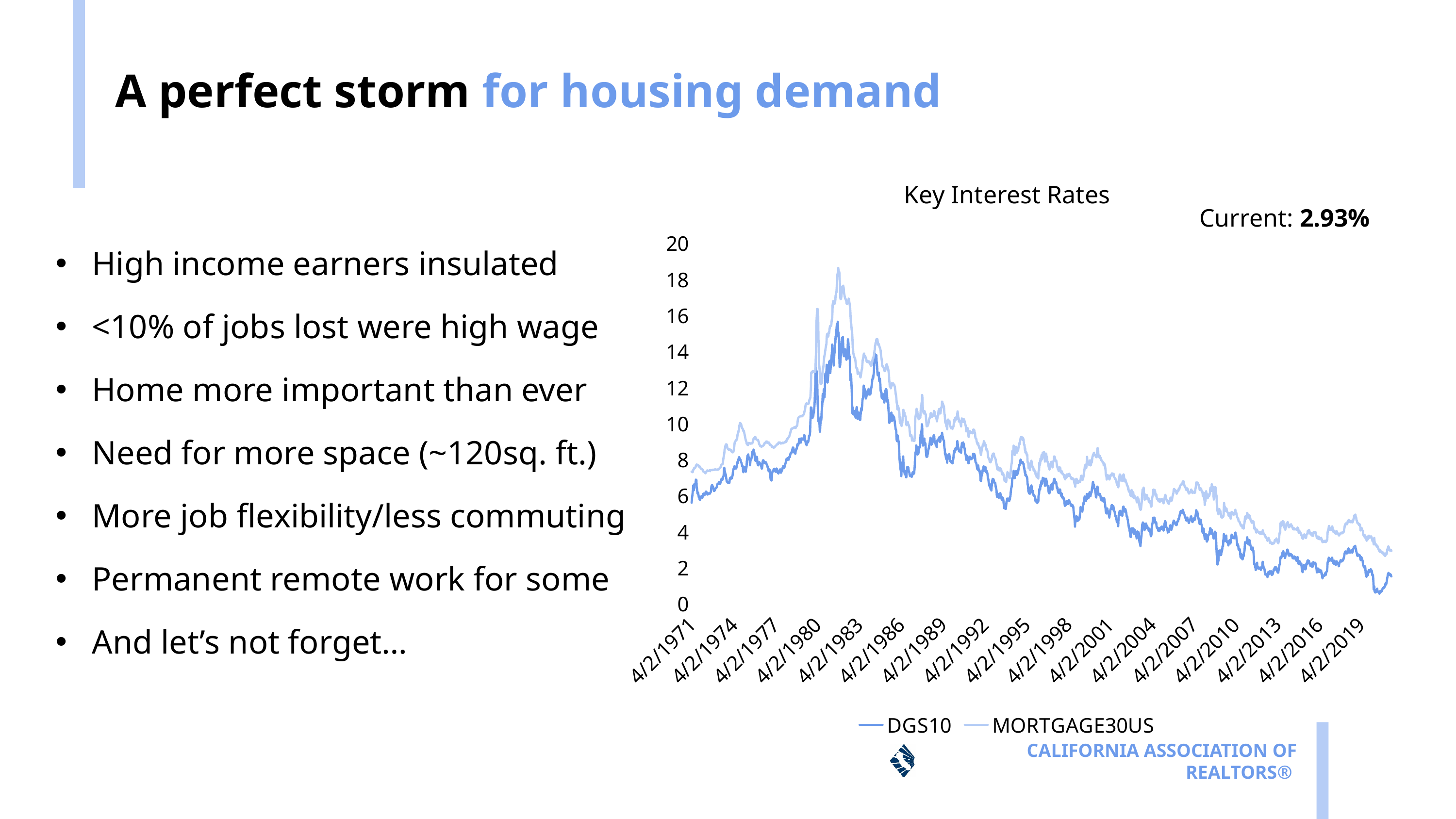
In the Key Interest Rates chart, is the peak value of DGS10 greater or less than 14? greater In the Key Interest Rates chart, which series reaches the highest peak? MORTGAGE30US How many series does the legend of the Key Interest Rates chart list? 2 In the Key Interest Rates chart, is the DGS10 value at 4/2/2019 greater or less than 4? less What is the title of the chart on the slide? Key Interest Rates In the Key Interest Rates chart, do the values generally rise or fall from 4/2/1983 to 4/2/2019? fall What current value is annotated above the Key Interest Rates chart? 2.93% In the Key Interest Rates chart, which series is higher around 4/2/1983, DGS10 or MORTGAGE30US? MORTGAGE30US What kind of chart is the Key Interest Rates chart? line chart What are the two series named in the legend of the Key Interest Rates chart? DGS10 and MORTGAGE30US How many date labels are shown on the x axis of the Key Interest Rates chart? 17 In the Key Interest Rates chart, is the peak value of MORTGAGE30US greater or less than 16? greater